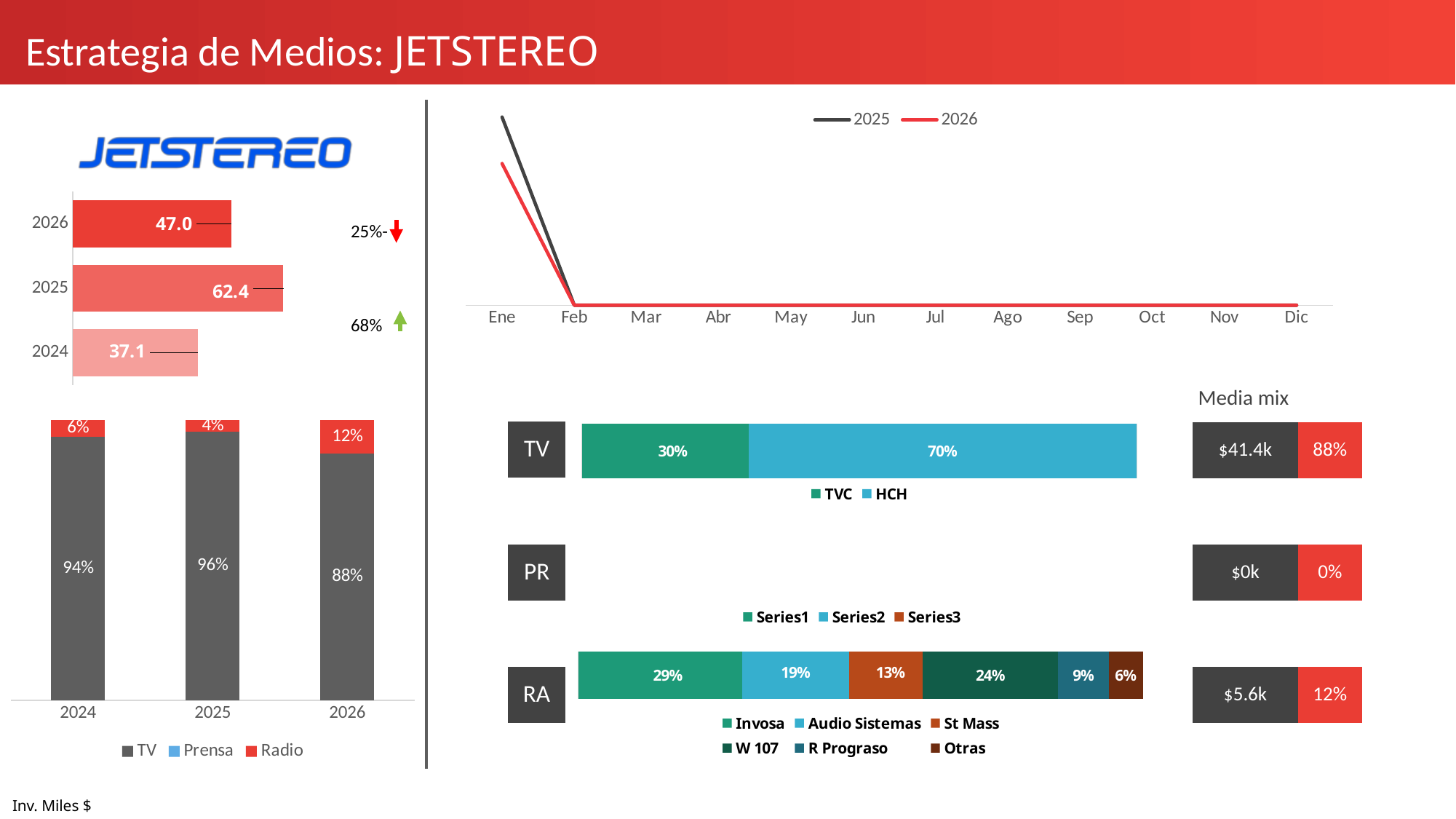
In the stacked bar chart at the bottom left, is the Radio share larger in 2025 or in 2026? 2026 In the line chart at the top right, how many series does the legend list? 2 In the TV stacked bar on the right, what is the share for HCH? 70% In the horizontal bar chart of yearly investment at the top left, which year has the lowest value? 2024 In the RA stacked bar on the right, which station has the highest share? Invosa In the horizontal bar chart of yearly investment at the top left, how many years are shown? 3 In the horizontal bar chart of yearly investment at the top left, what is the value for 2025? 62.4 In the Media mix boxes on the right, what is the investment amount for RA? $5.6k In the stacked bar chart at the bottom left, what is the TV share for 2026? 88% In the stacked bar chart at the bottom left, what is the Radio share for 2024? 6% In the stacked bar chart at the bottom left, how many series does the legend list? 3 In the horizontal bar chart of yearly investment at the top left, what is the difference between the 2025 and 2026 values? 15.4